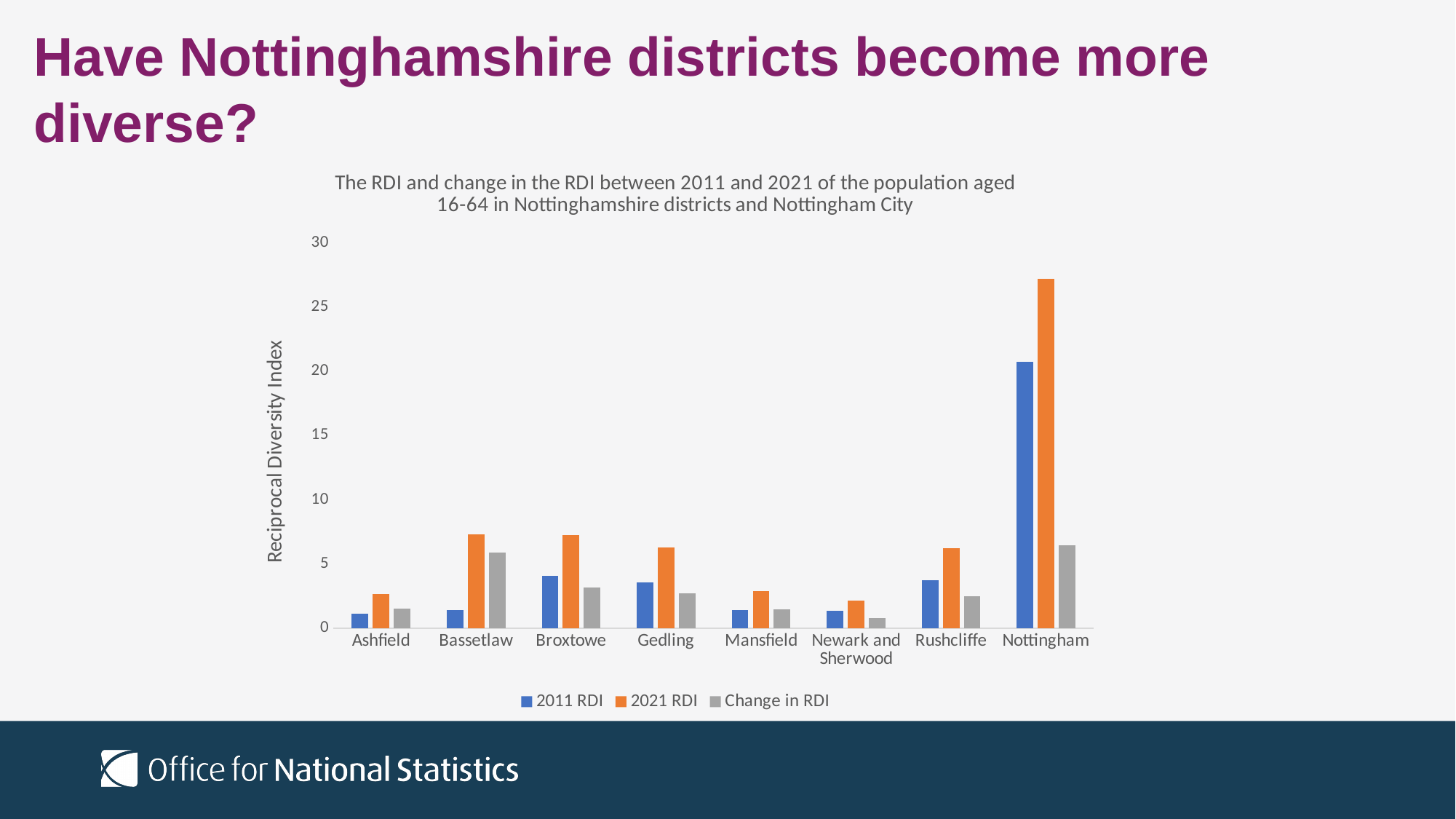
Is the 2011 RDI for Nottingham greater or less than 20? greater How many series does the chart's legend list? 3 Which district has the lowest Change in RDI? Newark and Sherwood What is the label on the vertical axis of the chart? Reciprocal Diversity Index Is the 2021 RDI for Nottingham greater or less than 25? greater Which district has the highest 2011 RDI? Nottingham Is the 2021 RDI for Bassetlaw greater or less than 5? greater How many districts are shown on the x axis of the chart? 8 Which district has the highest 2021 RDI? Nottingham What kind of chart is shown on the slide? bar chart Which is larger: the 2011 RDI for Rushcliffe or the 2011 RDI for Mansfield? Rushcliffe